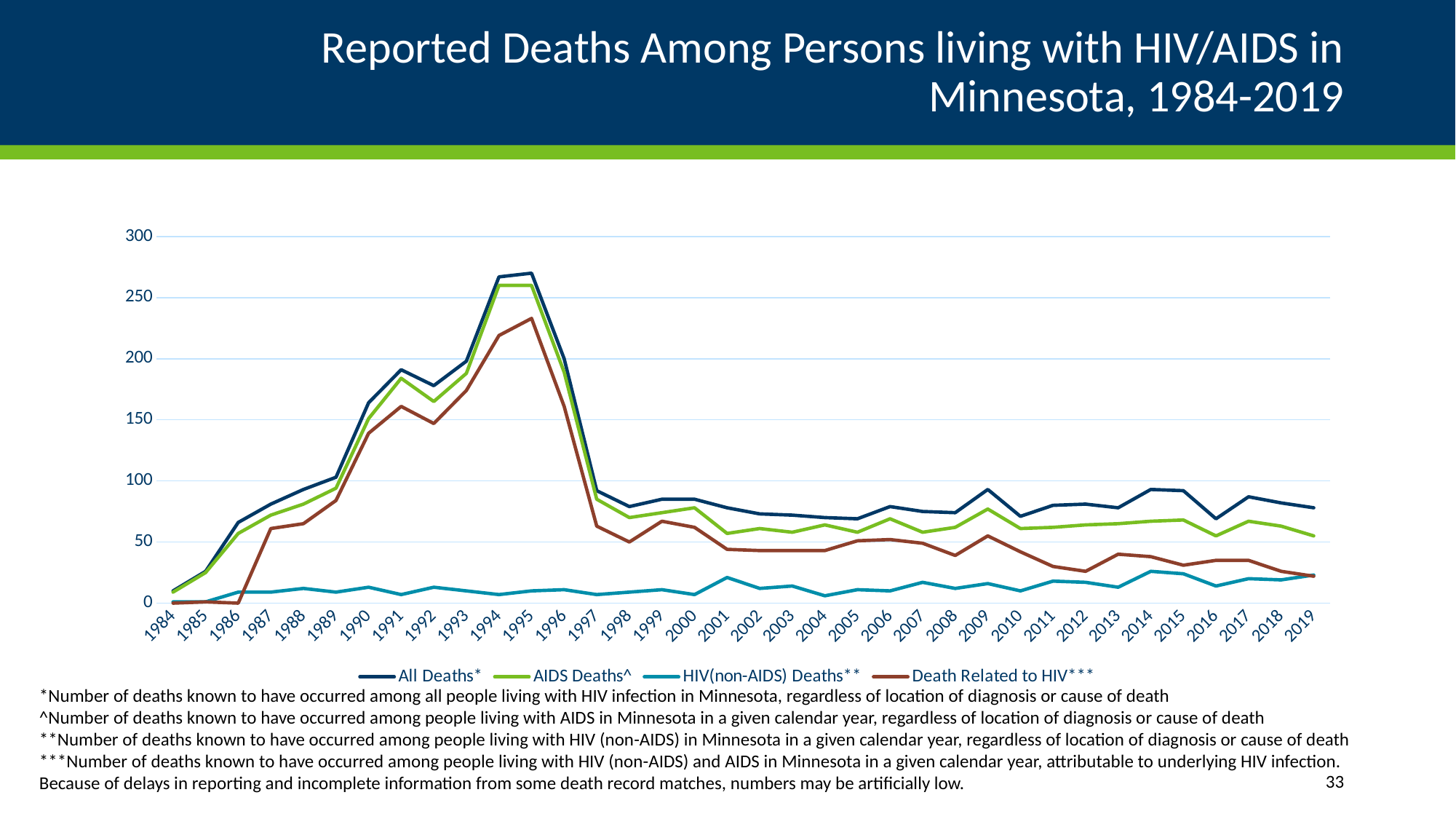
What kind of chart is shown on the slide? line chart What is the title of the chart? Reported Deaths Among Persons living with HIV/AIDS in Minnesota, 1984-2019 Which series has the lowest values across nearly all years? HIV(non-AIDS) Deaths Do All Deaths rise or fall from 1984 to 1991? rise How many series does the legend list? 4 In which year does the Death Related to HIV line reach its highest point? 1995 In 1987, which is larger: AIDS Deaths or Death Related to HIV? AIDS Deaths How many years are plotted along the x axis? 36 Is the value for AIDS Deaths in 2001 greater or less than 100? less Do All Deaths rise or fall from 1995 to 1997? fall Is the value for All Deaths in 1995 greater or less than 250? greater Is the value for Death Related to HIV in 1986 greater or less than 50? less